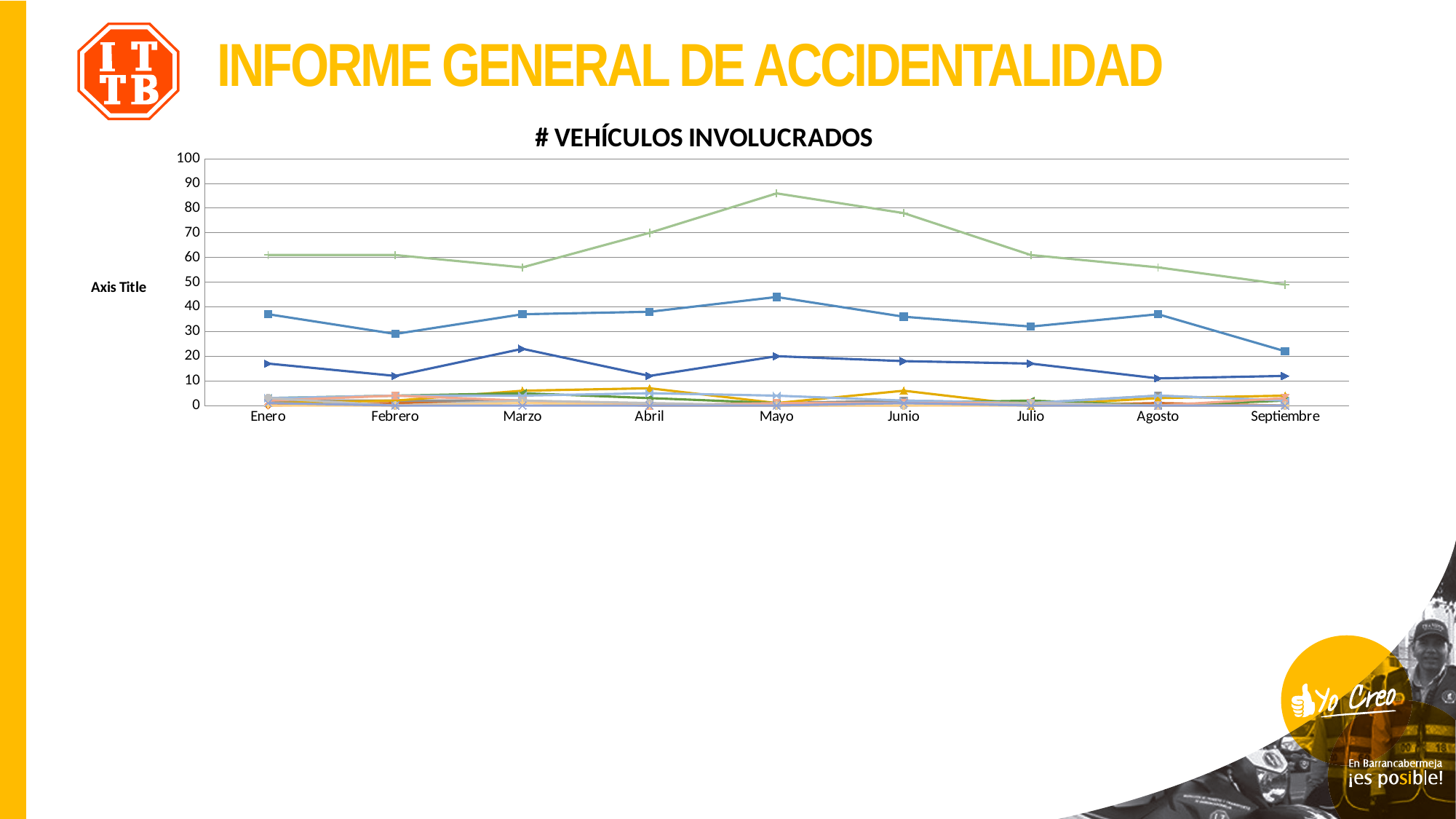
What text is shown as the vertical axis title? Axis Title Is the value of the second-highest (blue, square markers) line in Mayo greater or less than 40? greater In which month does the topmost (light green) line reach its lowest value? Septiembre Does the topmost (light green) line rise or fall from Mayo to Septiembre? Fall How many months are shown along the x axis? 9 What is the title of the chart? # VEHÍCULOS INVOLUCRADOS Is the value of the topmost (light green) line in Marzo greater or less than 60? less Which line is higher in Enero: the topmost light green line or the blue line with square markers? The light green line Is the value of the second-highest (blue, square markers) line in Septiembre greater or less than 30? less In which month does the topmost (light green) line reach its highest value? Mayo What kind of chart is shown on the slide? Line chart